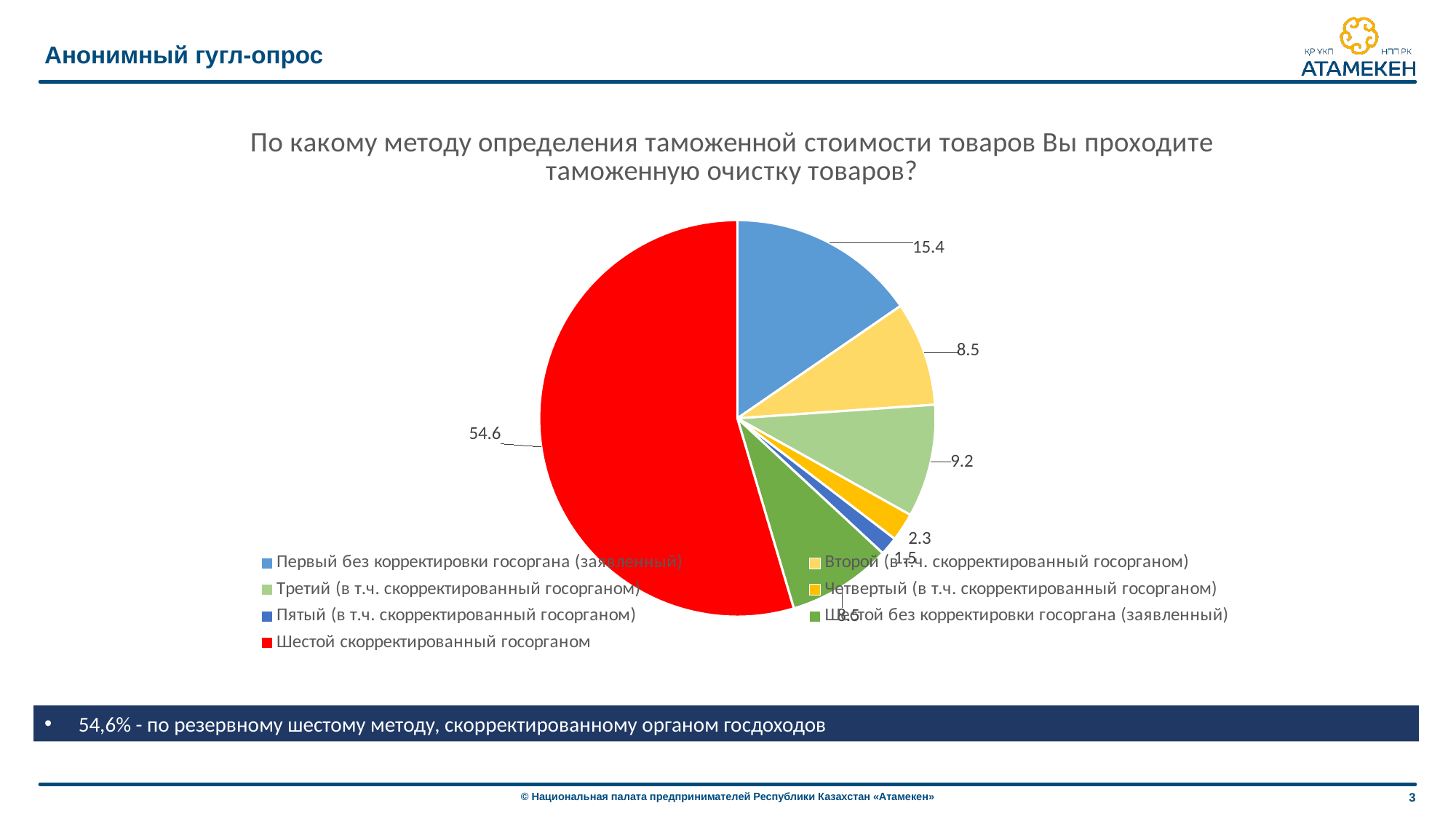
Which slice is larger: "Первый без корректировки госоргана (заявленный)" or "Третий (в т.ч. скорректированный госорганом)"? Первый без корректировки госоргана (заявленный) Which category has the smallest slice of the pie? Пятый (в т.ч. скорректированный госорганом) What is the title of the pie chart? По какому методу определения таможенной стоимости товаров Вы проходите таможенную очистку товаров? Which category has the largest slice of the pie? Шестой скорректированный госорганом What is the difference between the values for "Шестой скорректированный госорганом" and "Первый без корректировки госоргана (заявленный)"? 39.2 What value is shown for the slice "Первый без корректировки госоргана (заявленный)"? 15.4 How many categories does the legend of the pie chart list? 7 What value is shown for the slice "Третий (в т.ч. скорректированный госорганом)"? 9.2 What value is shown for the slice "Четвертый (в т.ч. скорректированный госорганом)"? 2.3 What kind of chart is shown on the slide? pie chart What value is shown for the slice "Шестой скорректированный госорганом"? 54.6 What value is shown for the slice "Второй (в т.ч. скорректированный госорганом)"? 8.5